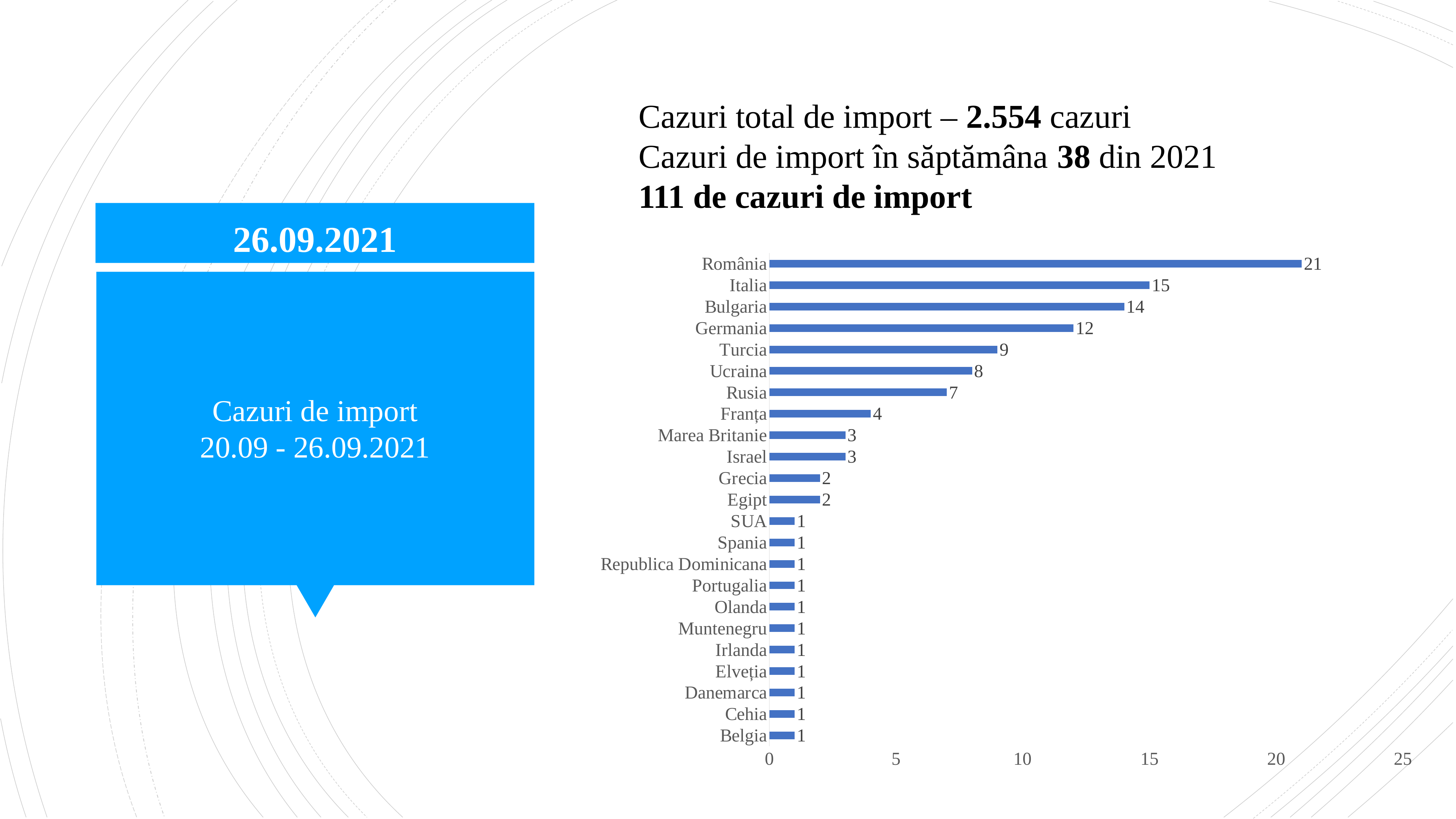
What type of chart is shown on the slide? bar chart Which country has the highest value? România What is the highest value shown on the horizontal axis? 25 What is the difference between the values for România and Italia? 6 What is the value for Bulgaria? 14 What is the value for Turcia? 9 What is the value for România? 21 Is the value for Germania greater or less than 10? greater Which is larger, the value for Ucraina or the value for Rusia? Ucraina What is the difference between the values for Germania and Rusia? 5 How many countries are shown in the chart? 23 What is the value for Franța? 4